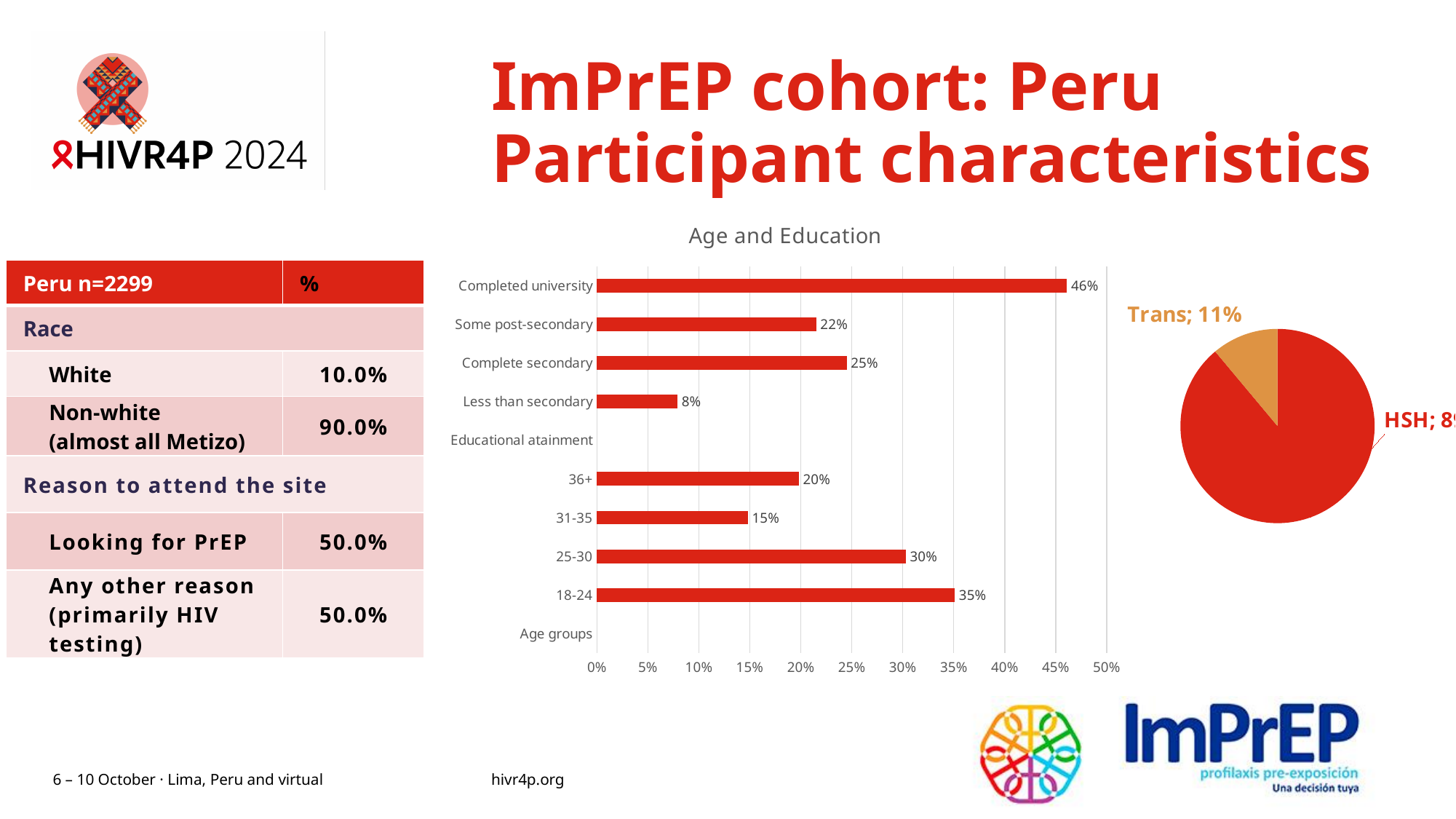
In the 'Age and Education' bar chart, what is the value for the 18-24 age group? 35% In the 'Age and Education' bar chart, what is the difference between the values for 18-24 and 25-30? 5% In the 'Age and Education' bar chart, what is the value for Completed university? 46% In the 'Age and Education' bar chart, which category has the lowest value? Less than secondary In the 'Age and Education' bar chart, which category has the highest value? Completed university In the pie chart on the right, what share is labelled Trans? 11% What kind of chart is the 'Age and Education' chart? Bar chart In the 'Age and Education' bar chart, what is the value for the 31-35 age group? 15% In the pie chart on the right, which slice is larger: HSH or Trans? HSH In the 'Age and Education' bar chart, what is the value for Less than secondary? 8% In the 'Age and Education' bar chart, which is larger: Some post-secondary or Complete secondary? Complete secondary In the 'Age and Education' bar chart, is the value for 36+ greater or less than 25%? less